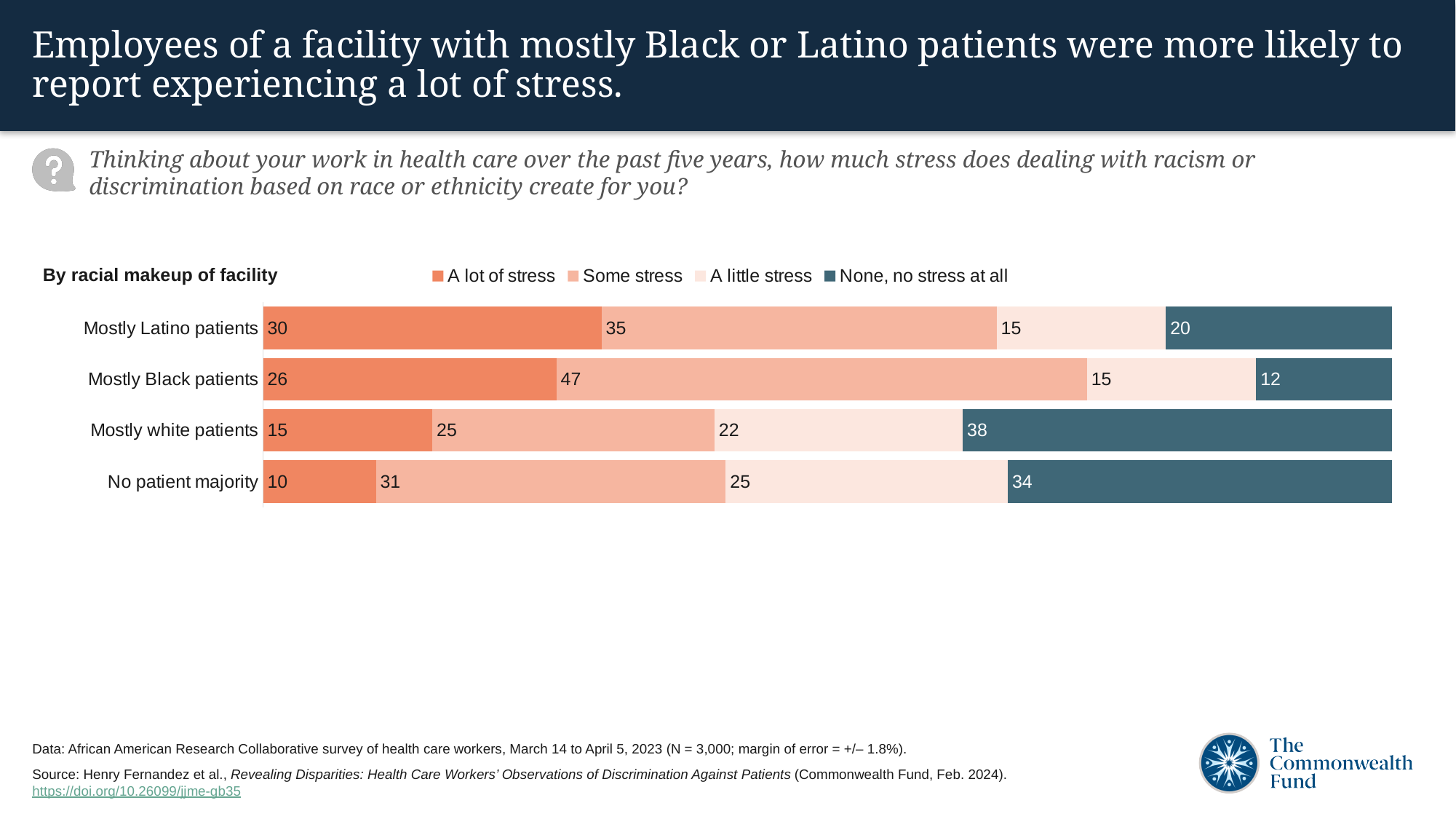
What is the value for "Some stress" for Mostly Black patients? 47 Which facility type has the highest value for "A lot of stress"? Mostly Latino patients What is the total of the stacked bar for Mostly Latino patients? 100 What is the value for "A lot of stress" for Mostly Latino patients? 30 What is the value for "A little stress" for No patient majority? 25 Which facility type has the lowest value for "None, no stress at all"? Mostly Black patients What kind of chart is shown on the slide? Stacked bar chart Which is larger: the "Some stress" value for Mostly Black patients or for No patient majority? Mostly Black patients How many facility categories are shown in the chart? 4 What is the difference between the "A lot of stress" values for Mostly Latino patients and Mostly white patients? 15 What is the value for "None, no stress at all" for Mostly white patients? 38 How many series does the legend list? 4